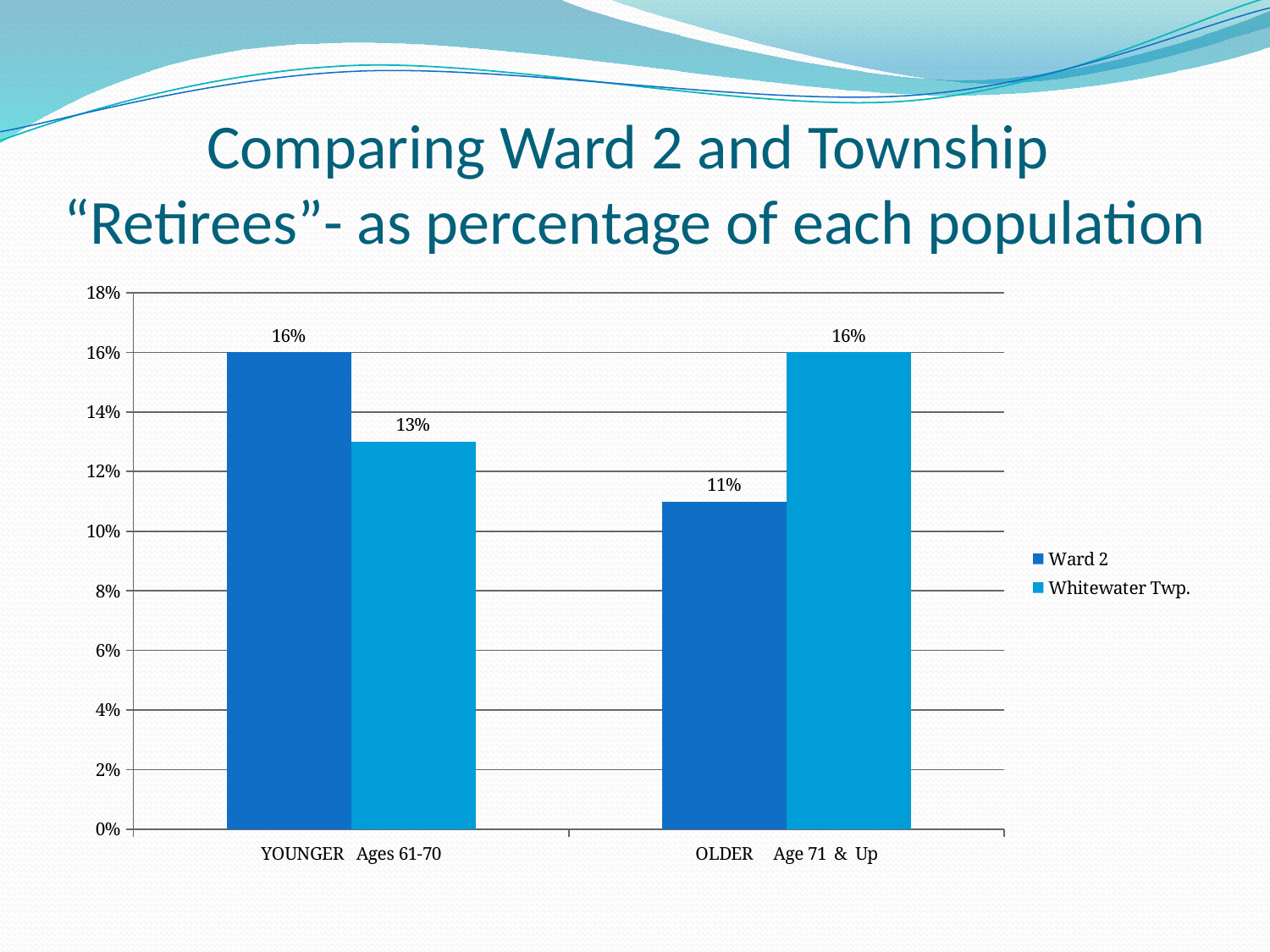
What kind of chart is shown on the slide? Bar chart Which is larger in the OLDER Age 71 & Up category, Ward 2 or Whitewater Twp.? Whitewater Twp. What is the value for Whitewater Twp. in the OLDER Age 71 & Up category? 16% How many categories are shown on the x axis? 2 What is the difference between the Whitewater Twp. and Ward 2 values in the OLDER Age 71 & Up category? 5% What is the value for Ward 2 in the YOUNGER Ages 61-70 category? 16% What is the value for Whitewater Twp. in the YOUNGER Ages 61-70 category? 13% In which category is the Whitewater Twp. value highest? OLDER Age 71 & Up What is the difference between the Ward 2 and Whitewater Twp. values in the YOUNGER Ages 61-70 category? 3% What is the value for Ward 2 in the OLDER Age 71 & Up category? 11% How many series does the legend list? 2 In which category is the Ward 2 value lowest? OLDER Age 71 & Up